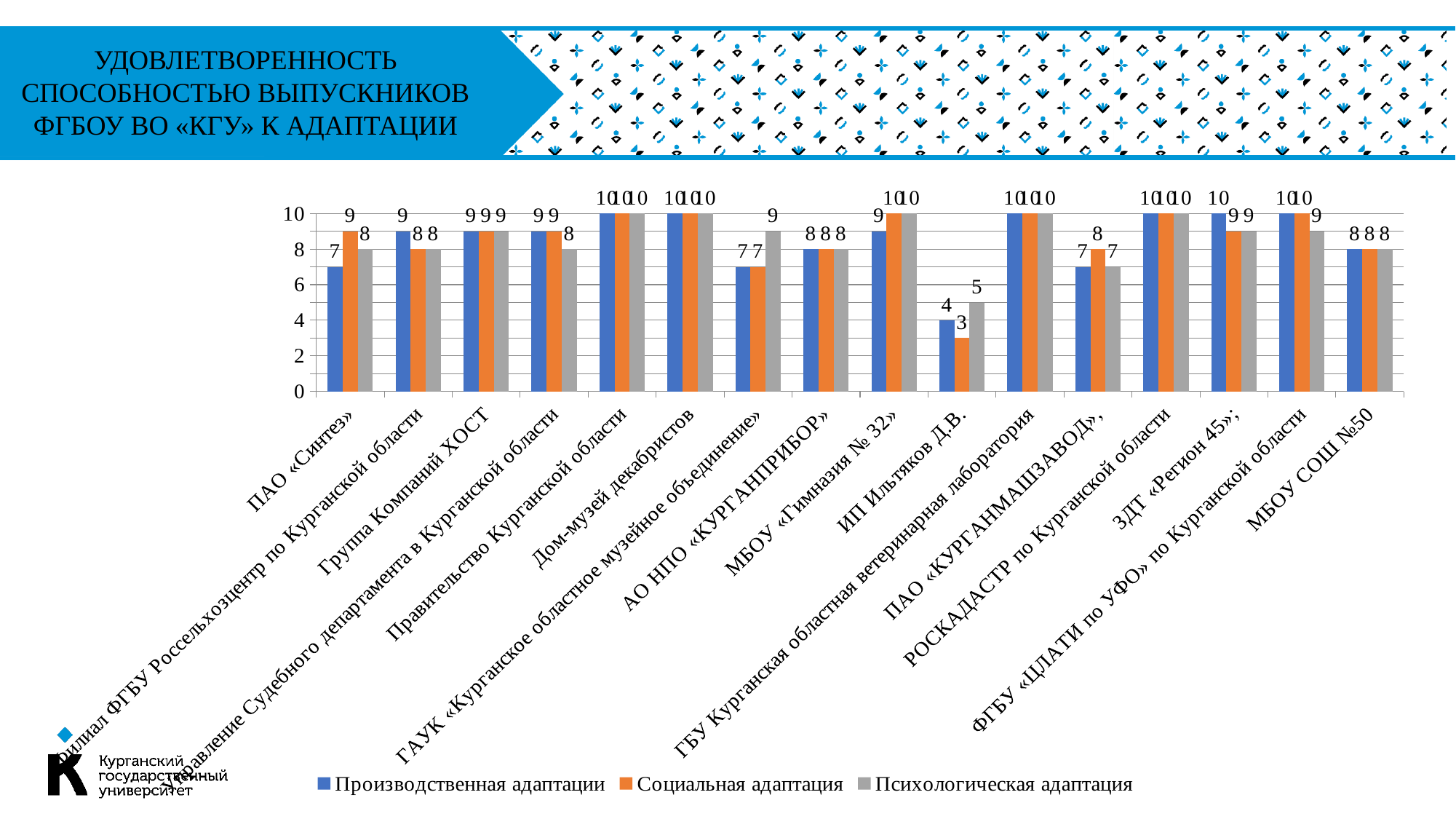
Which organisation has the lowest value for Производственная адаптации? ИП Ильтяков Д.В. What is the difference between the Социальная адаптация and Производственная адаптации values for ПАО «Синтез»? 2 For ГАУК «Курганское областное музейное объединение», which is larger: Психологическая адаптация or Социальная адаптация? Психологическая адаптация How many series does the legend list? 3 Which series is shown in orange in the legend? Социальная адаптация What is the value of Социальная адаптация for МБОУ «Гимназия № 32»? 10 What type of chart is shown on the slide? bar chart What is the value of Социальная адаптация for ИП Ильтяков Д.В.? 3 What is the value of Производственная адаптации for ПАО «Синтез»? 7 What is the value of Психологическая адаптация for ПАО «КУРГАНМАШЗАВОД»? 7 How many organisations (categories) are shown on the x axis? 16 What is the value of Психологическая адаптация for ФГБУ «ЦЛАТИ по УФО» по Курганской области? 9